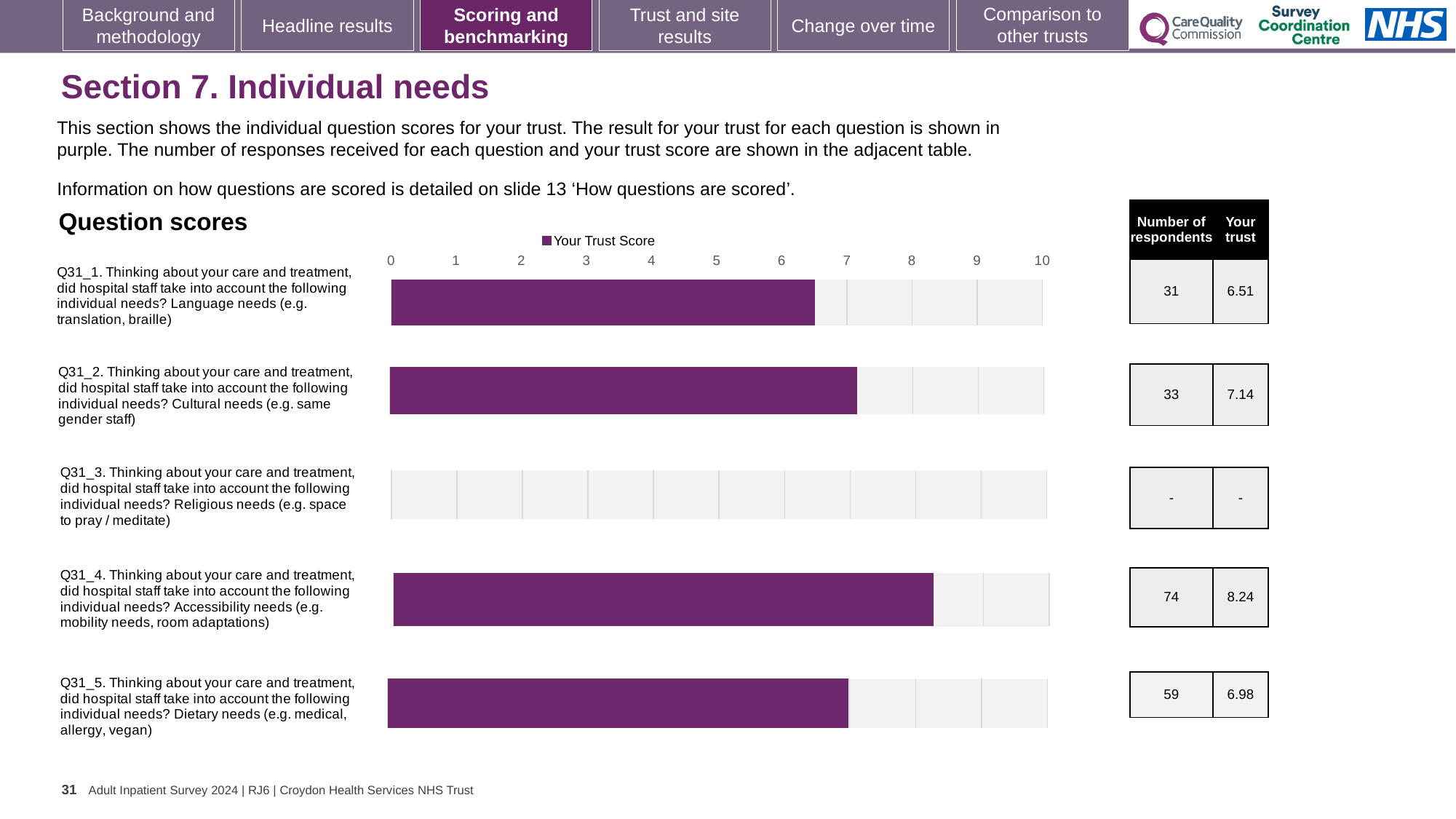
What is the difference between the trust scores for Q31_4 and Q31_1? 1.73 Among the questions with a plotted bar, which has the lowest trust score? Q31_1 (Language needs) Which has the higher trust score, Q31_2 (Cultural needs) or Q31_5 (Dietary needs)? Q31_2 (Cultural needs) How many series does the chart legend list? 1 How many questions are listed in the Question scores chart? 5 What is the trust score for Q31_4 (Accessibility needs)? 8.24 Which question has the highest trust score on the chart? Q31_4 (Accessibility needs) What is the trust score for Q31_1 (Language needs)? 6.51 What type of chart is used to show the question scores? Bar chart Is the trust score bar for Q31_2 greater or less than 8? less How many respondents answered Q31_5 (Dietary needs)? 59 Is the trust score bar for Q31_1 greater or less than 6? greater